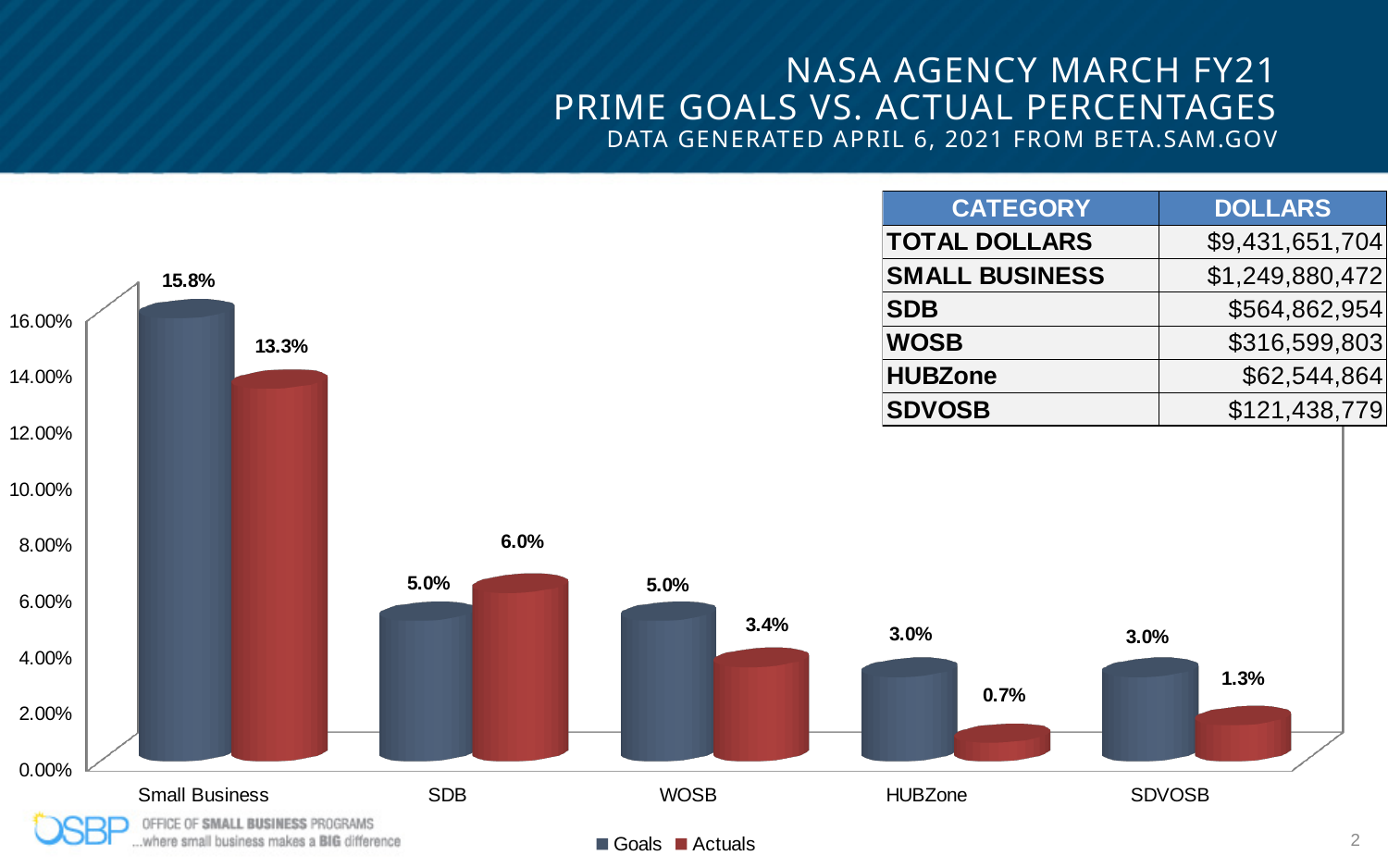
What kind of chart is shown on the slide? Bar chart What is the Actuals value for HUBZone? 0.7% What is the Goals value for Small Business? 15.8% Which series is shown in red in the legend? Actuals Which category has the lowest Actuals value? HUBZone What is the Actuals value for WOSB? 3.4% Which is larger for SDB, the Goals value or the Actuals value? Actuals How many categories are shown on the x axis? 5 How many series does the legend list? 2 What is the difference between the Actuals values for SDB and SDVOSB? 4.7% Which category has the highest Actuals value? Small Business What is the difference between the Goals and Actuals values for Small Business? 2.5%